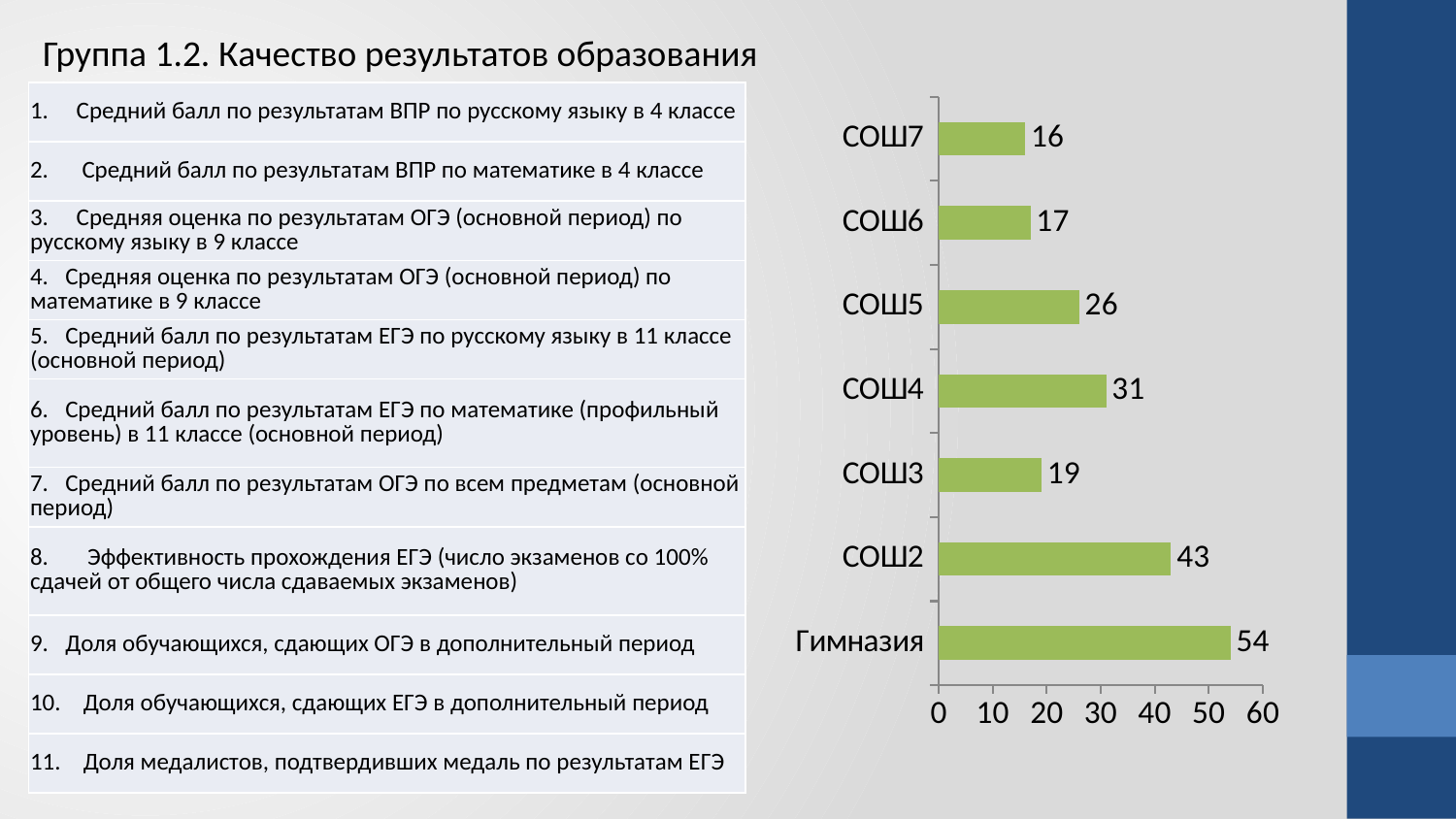
What is the value for СОШ6? 17 What is the difference between the values for Гимназия and СОШ2? 11 Is the value for СОШ2 greater or less than 40? greater Which is larger, the value for СОШ4 or the value for СОШ5? СОШ4 What is the value for Гимназия? 54 What kind of chart is shown on the slide? bar chart Which category has the highest value? Гимназия Which category has the lowest value? СОШ7 What is the value for СОШ2? 43 How many categories are shown in the chart? 7 What is the difference between the values for СОШ4 and СОШ3? 12 What is the value for СОШ5? 26